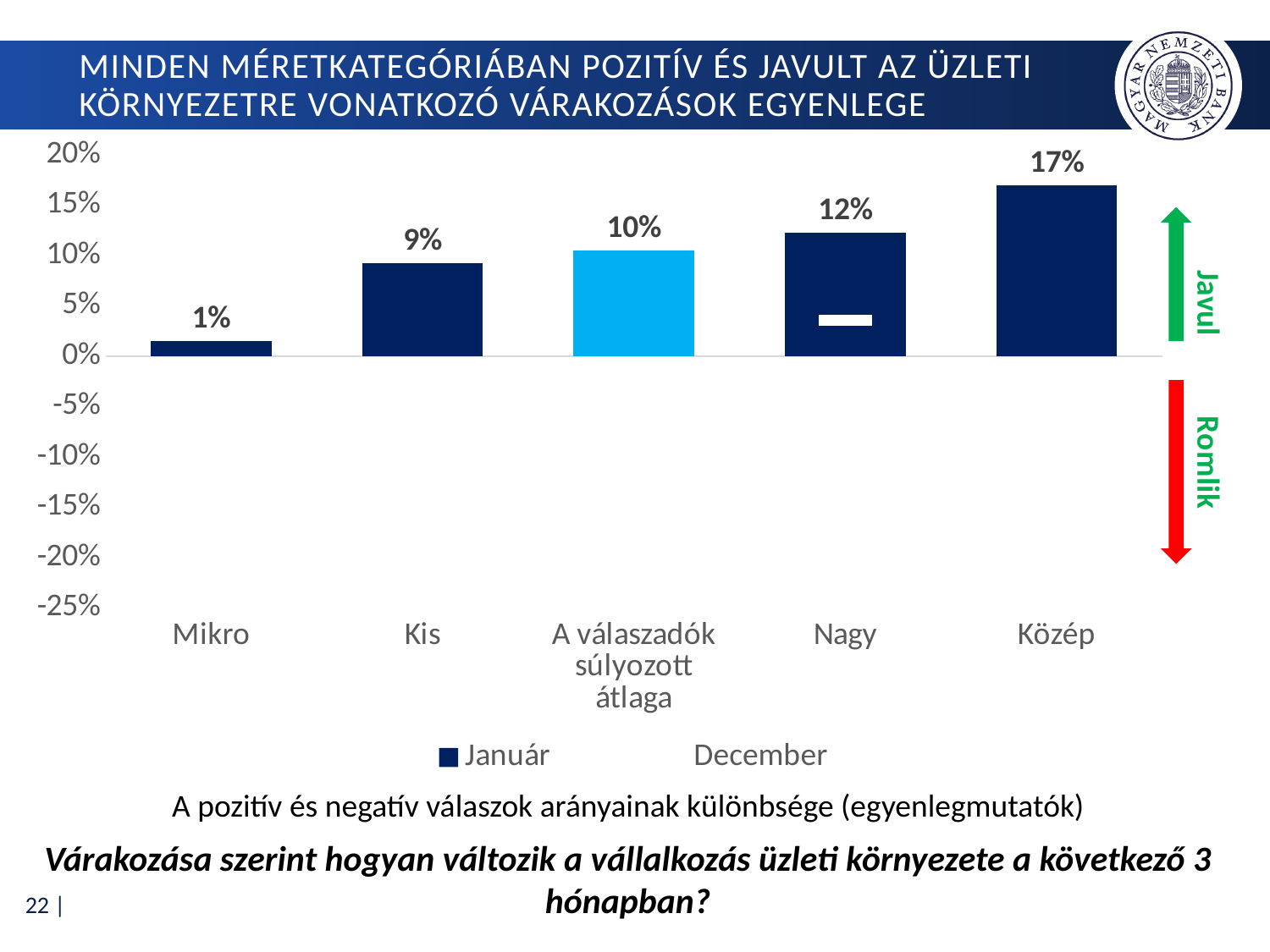
Which category has the highest value? Közép How many series does the legend list? 2 How many categories are shown on the x axis? 5 What kind of chart is shown on the slide? bar chart What is the value for Mikro? 1% What is the value for Kis? 9% What is the difference between the values for Közép and Nagy? 5% Which is larger, the value for Kis or the value for Nagy? Nagy What is the value for Közép? 17% Which category has the lowest value? Mikro What is the value for A válaszadók súlyozott átlaga? 10% What is the value for Nagy? 12%